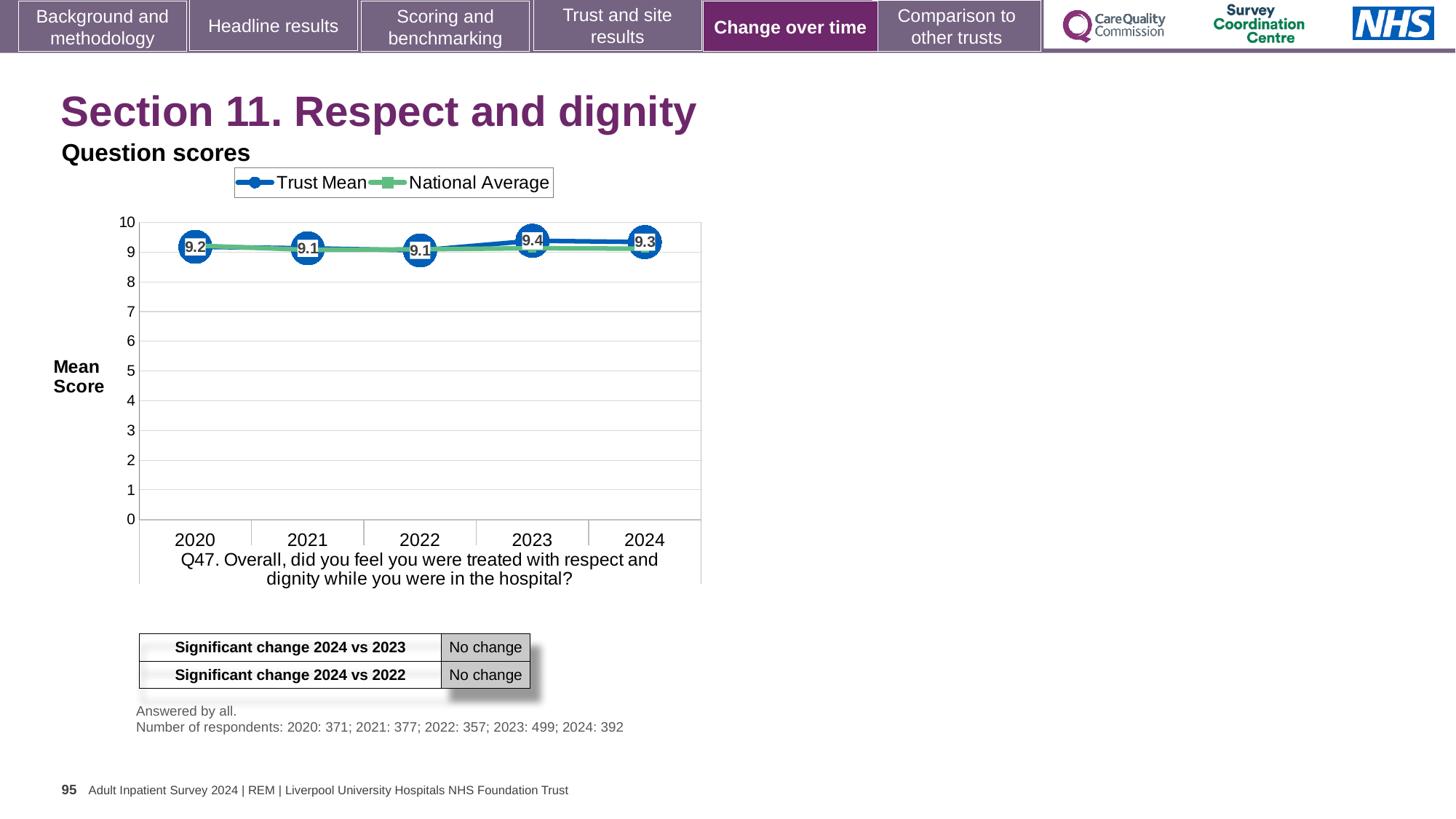
What is the Trust Mean value for 2023? 9.4 Does the Trust Mean rise or fall from 2022 to 2023? rise What is the Trust Mean value for 2024? 9.3 How many years are plotted on the x axis? 5 What is the Trust Mean value for 2020? 9.2 What is the difference between the Trust Mean in 2023 and in 2020? 0.2 In which year is the Trust Mean highest? 2023 What kind of chart is shown? line chart How many series does the legend list? 2 What are the two series named in the legend? Trust Mean and National Average Is the National Average value for 2024 greater or less than 8? greater Which is larger, the Trust Mean for 2023 or for 2021? 2023